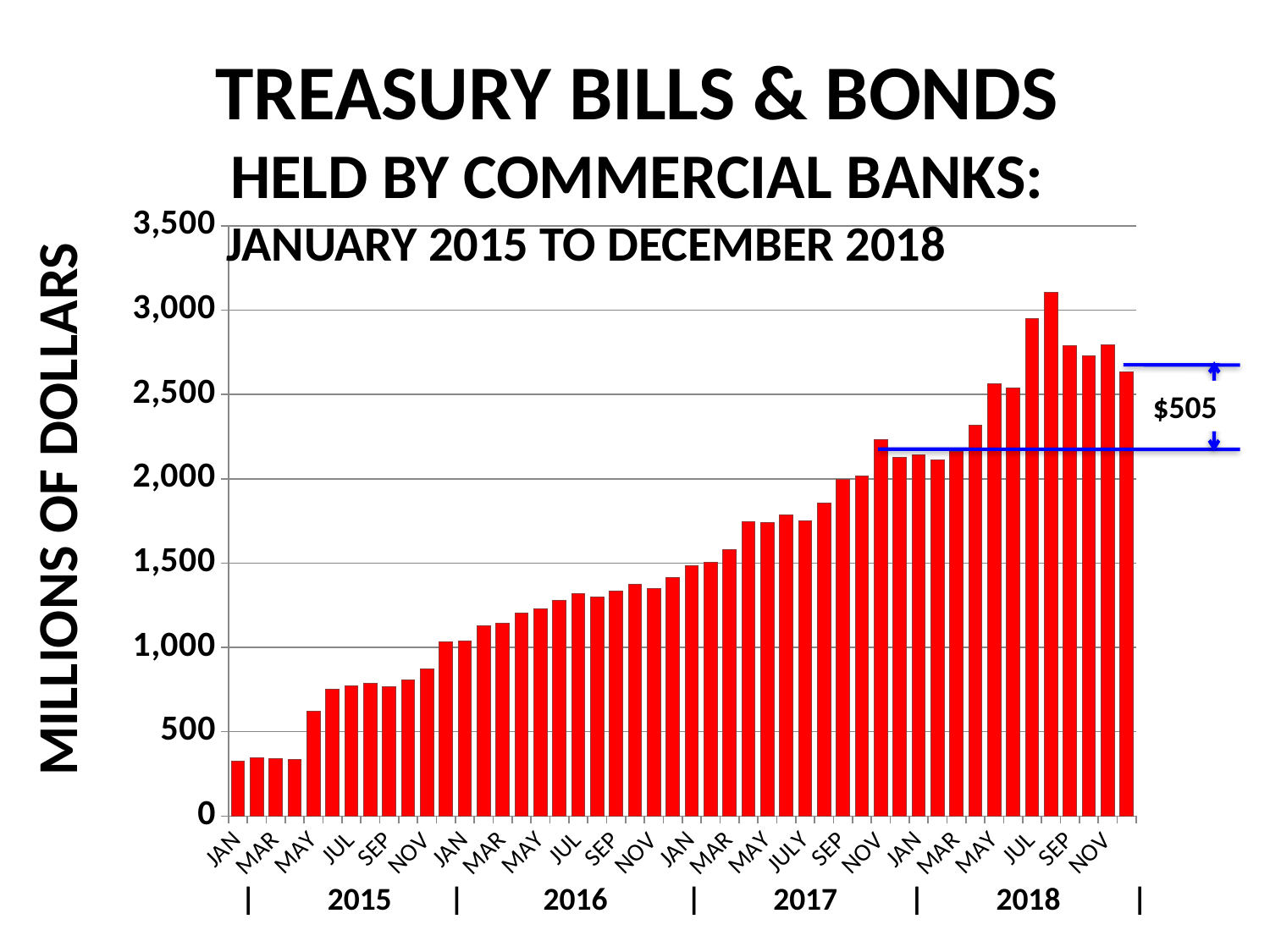
Do the values generally rise or fall from January 2015 to December 2018? rise How many years are labelled along the x axis? 4 Is the value for SEP 2018 greater or less than 3,000? less What is the title of the chart? TREASURY BILLS & BONDS HELD BY COMMERCIAL BANKS: JANUARY 2015 TO DECEMBER 2018 What kind of chart is shown on the slide? bar chart Is the value for JAN 2015 greater or less than 500? less What is the label on the vertical axis? MILLIONS OF DOLLARS Which is larger, the value for SEP 2017 or the value for SEP 2016? SEP 2017 Is the value for NOV 2018 greater or less than 2,500? greater Which month has the highest value on the chart? AUG 2018